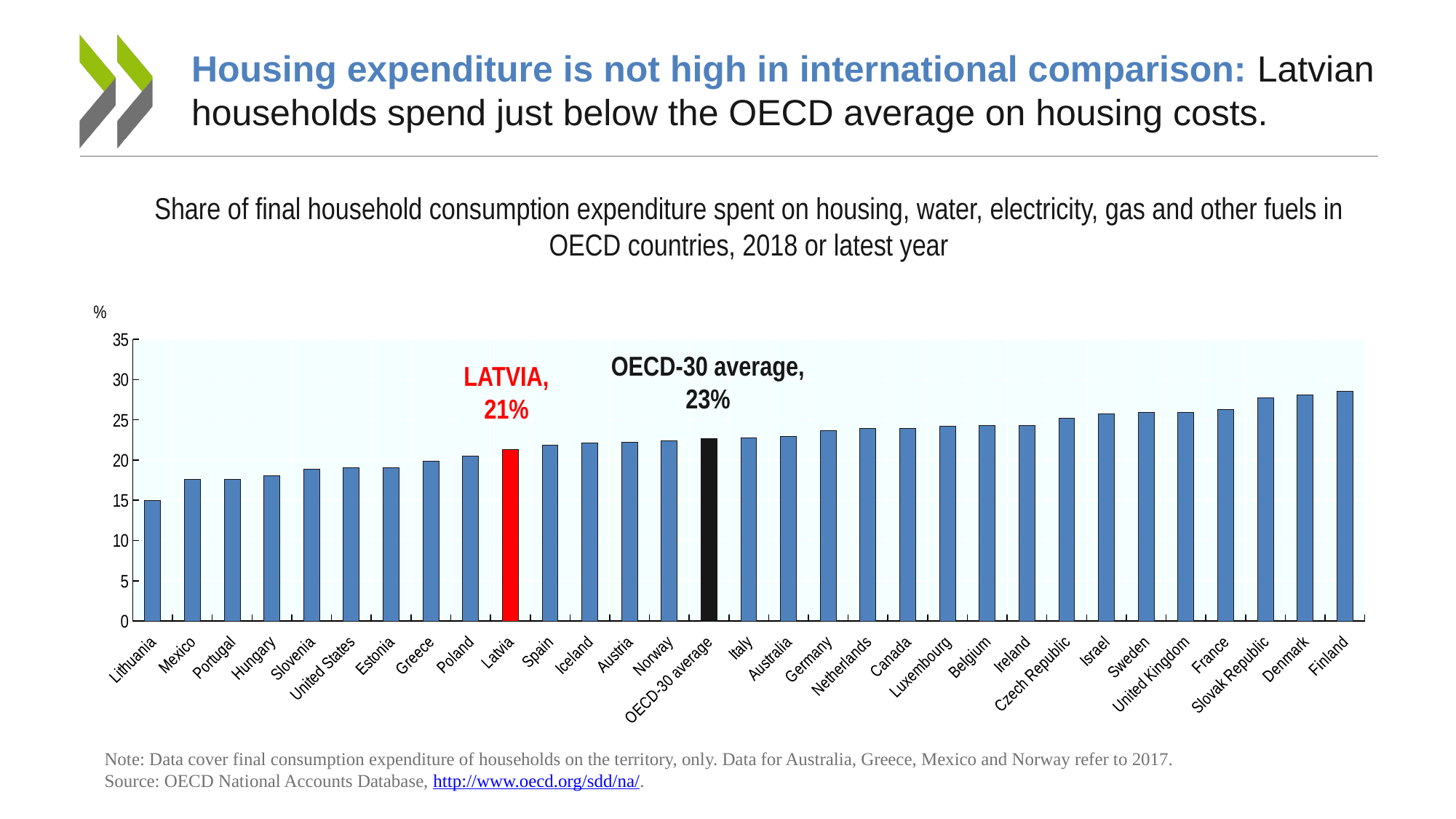
Which country has the lowest share of household expenditure spent on housing? Lithuania Which country has the highest share of household expenditure spent on housing? Finland Is the value for Finland greater or less than 25? greater What kind of chart is shown on the slide? Bar chart Which has the larger value, Mexico or Denmark? Denmark Do the values rise or fall from left to right along the x axis? Rise How many bars are plotted in the chart? 31 What colour is the bar for Latvia? Red What is the value shown for Latvia? 21% What is the value shown for the OECD-30 average? 23% By how many percentage points is the OECD-30 average above Latvia? 2 percentage points Is the value for Lithuania greater or less than 20? less